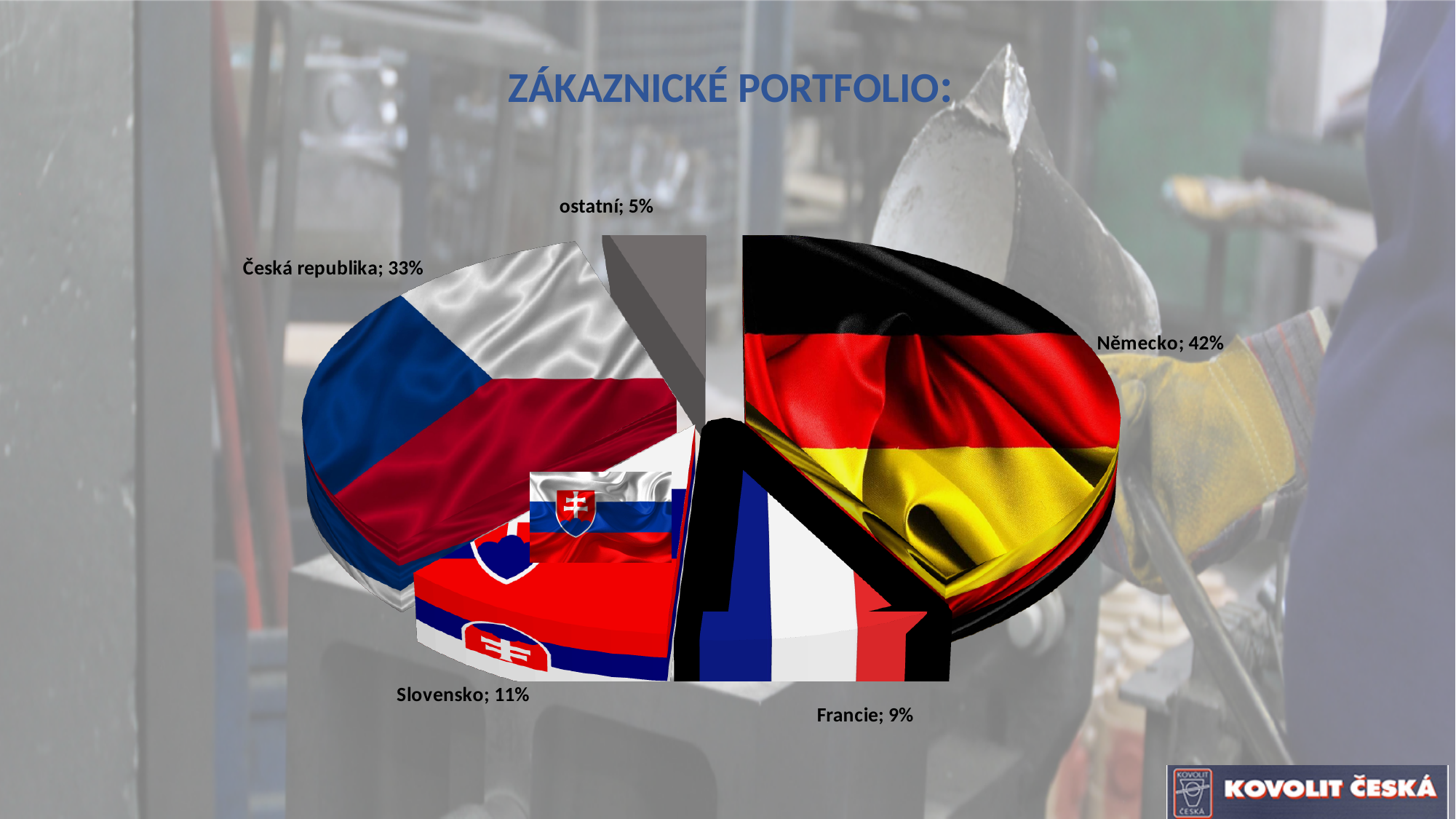
What share of the customer portfolio does Slovensko hold? 11% Which has a larger share, Slovensko or Francie? Slovensko Which category has the smallest share of the pie? ostatní What share of the customer portfolio does Německo hold? 42% What is the title of the slide? ZÁKAZNICKÉ PORTFOLIO: What share of the customer portfolio does Česká republika hold? 33% What share of the customer portfolio does Francie hold? 9% What is the difference in percentage points between Německo and Česká republika? 9 Which category has the largest share of the pie? Německo What share of the customer portfolio is labelled ostatní? 5% What kind of chart is shown on the slide? pie chart How many categories are shown in the pie chart? 5